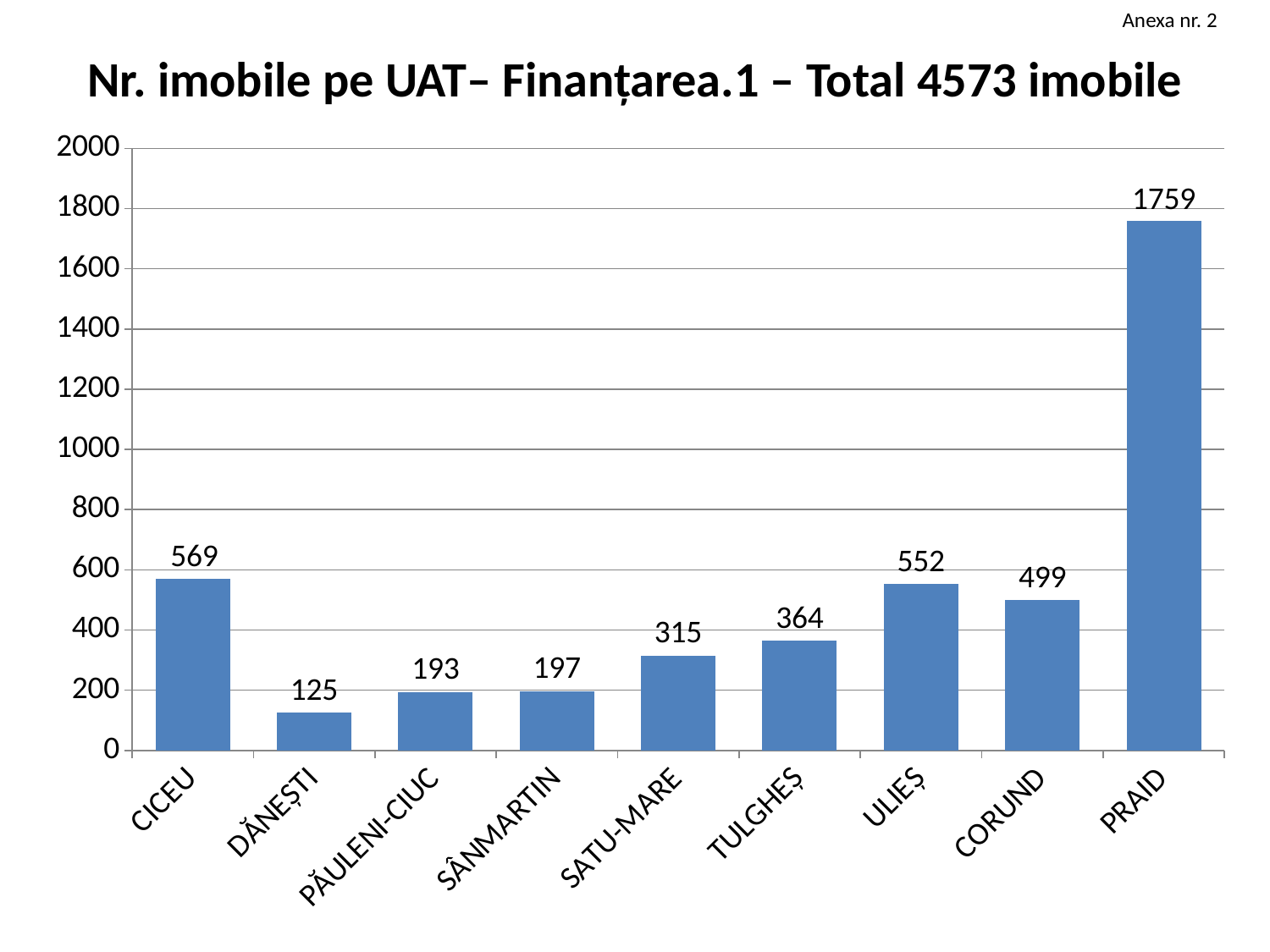
What is the difference between the values for PRAID and CORUND? 1260 Which category has the highest value? PRAID What is the value for PRAID? 1759 How many categories are shown on the x axis? 9 What is the title of the chart? Nr. imobile pe UAT– Finanțarea.1 – Total 4573 imobile What is the value for DĂNEȘTI? 125 What is the difference between the values for CICEU and ULIEȘ? 17 What is the value for TULGHEȘ? 364 Which is larger, the value for SATU-MARE or the value for TULGHEȘ? TULGHEȘ Is the value for CORUND greater or less than 400? greater Which category has the lowest value? DĂNEȘTI What kind of chart is shown on the slide? bar chart